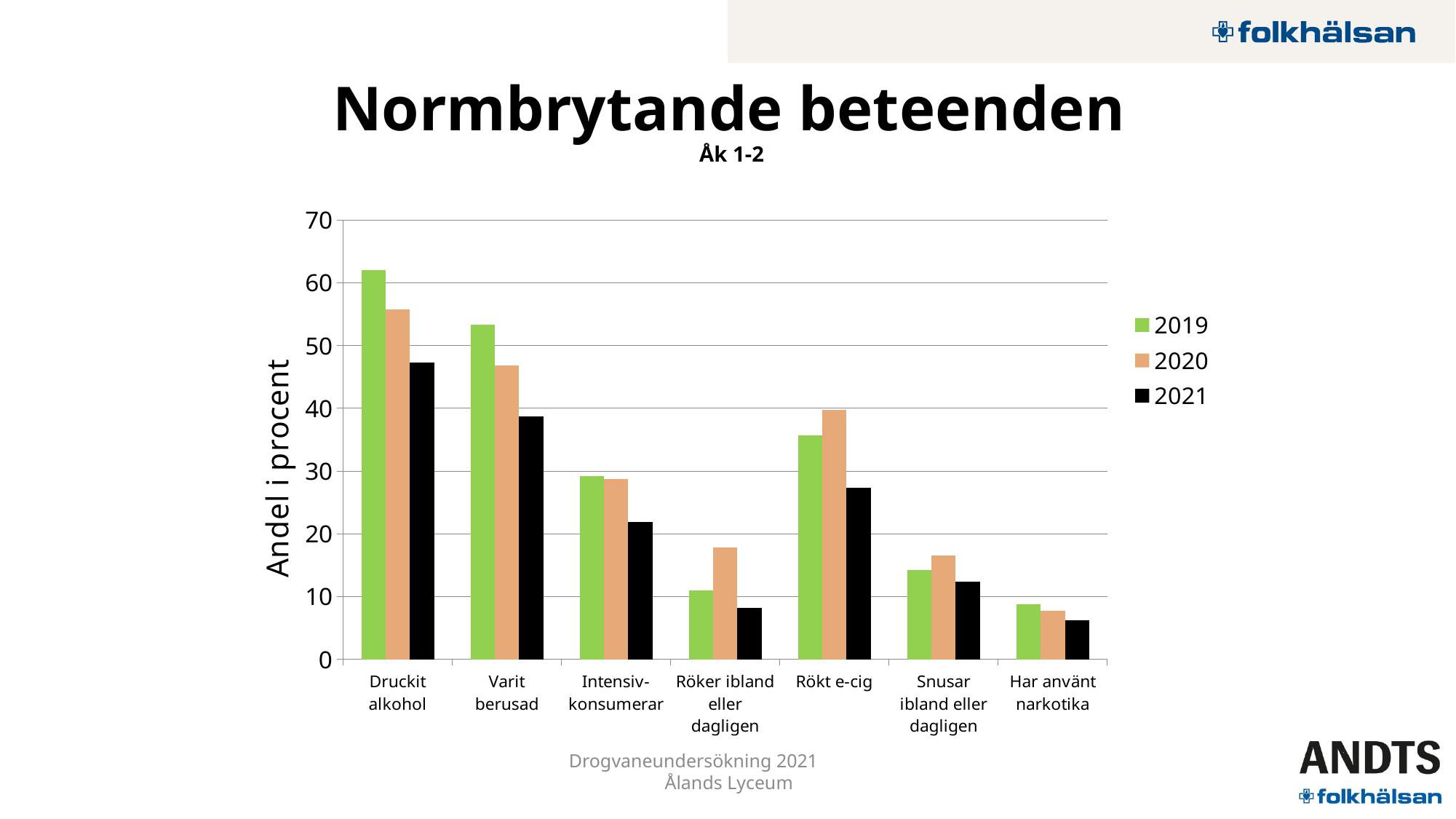
What is the label of the y axis? Andel i procent How many series does the legend list? 3 Is the 2019 value for Druckit alkohol greater or less than 50? greater Which category has the highest value for the 2019 series? Druckit alkohol For Druckit alkohol, do the values rise or fall from 2019 to 2021? fall For Rökt e-cig, which series has the larger value, 2019 or 2020? 2020 Is the 2020 value for Röker ibland eller dagligen greater or less than 20? less How many categories are shown on the x axis of the chart? 7 Which category has the lowest value for the 2021 series? Har använt narkotika Is the 2021 value for Rökt e-cig greater or less than 30? less What kind of chart is shown on the slide? bar chart